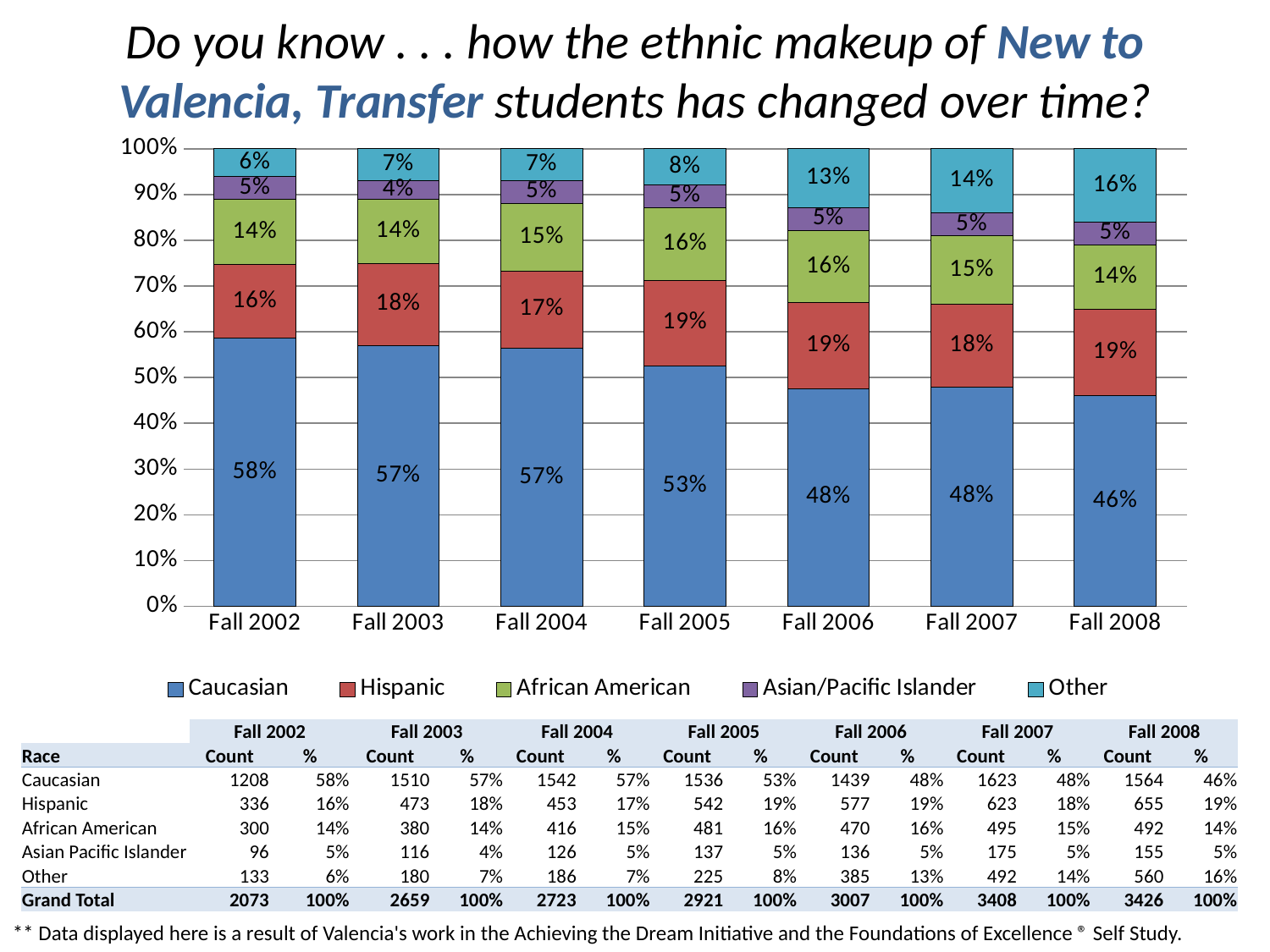
What colour represents the Caucasian series in the chart? Blue How many terms are shown on the x axis of the chart? 7 Does the Other share rise or fall from Fall 2002 to Fall 2008? Rises How many series does the legend list? 5 What is the value for the Other series in Fall 2008? 16% In which term is the Caucasian share the lowest? Fall 2008 What is the African American share in Fall 2005? 16% What kind of chart is shown on the slide? Stacked bar chart What percentage of New to Valencia Transfer students were Caucasian in Fall 2002? 58% In which term is the Caucasian share the highest? Fall 2002 Which term has the larger Hispanic share, Fall 2003 or Fall 2004? Fall 2003 By how many percentage points did the Caucasian share fall from Fall 2002 to Fall 2008? 12 percentage points